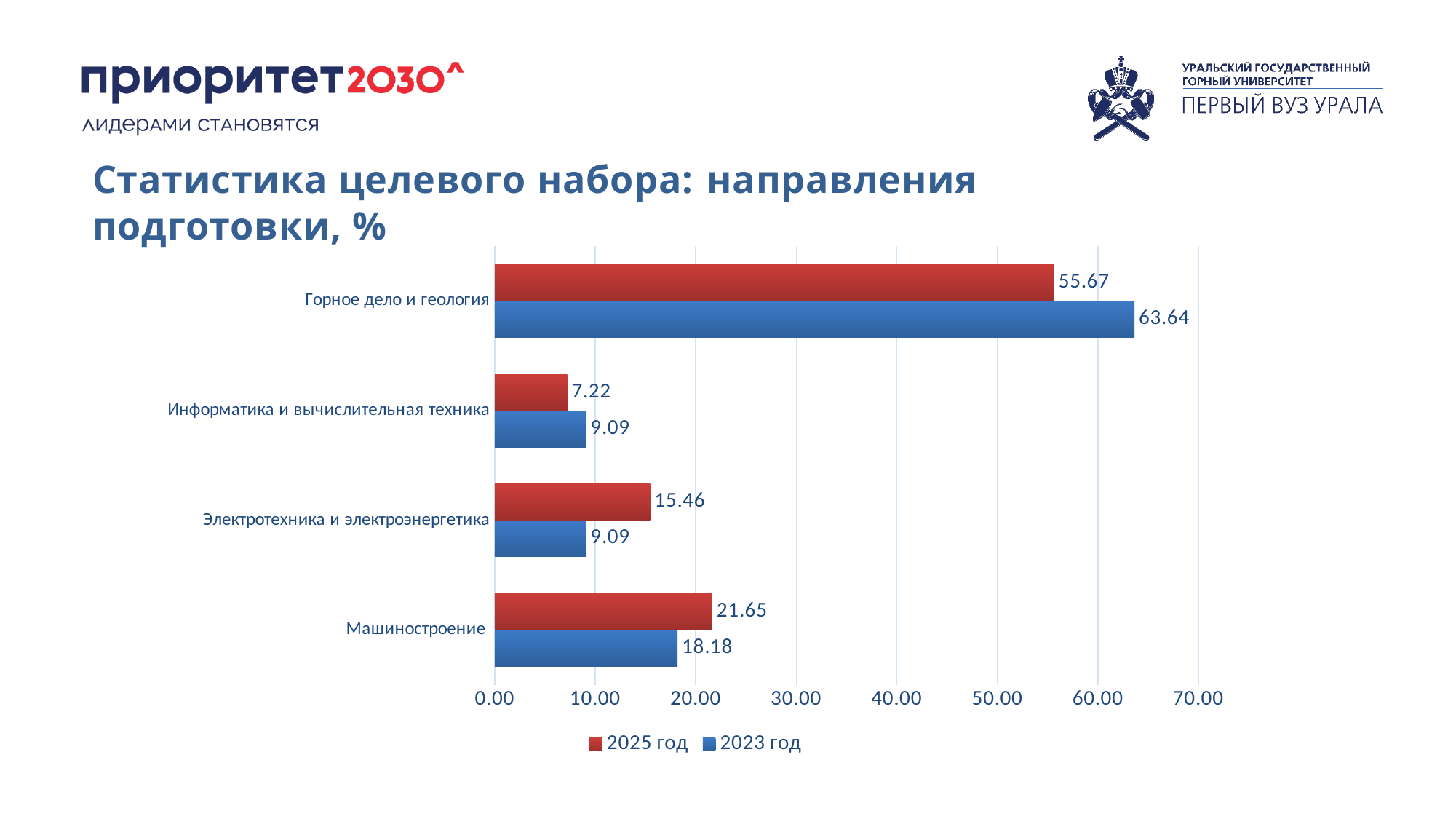
Which category has the lowest value in the 2025 год series? Информатика и вычислительная техника What is the difference between the 2023 год and 2025 год values for Горное дело и геология? 7.97 What is the value for Электротехника и электроэнергетика in the 2025 год series? 15.46 What is the value for Горное дело и геология in the 2025 год series? 55.67 Which is larger for Машиностроение: the 2025 год value or the 2023 год value? 2025 год What is the value for Машиностроение in the 2023 год series? 18.18 What is the value for Горное дело и геология in the 2023 год series? 63.64 What kind of chart is shown on the slide? Bar chart How many series does the legend list? 2 Which category has the highest value in the 2025 год series? Горное дело и геология How many categories are shown on the chart? 4 Which colour represents the 2023 год series? Blue